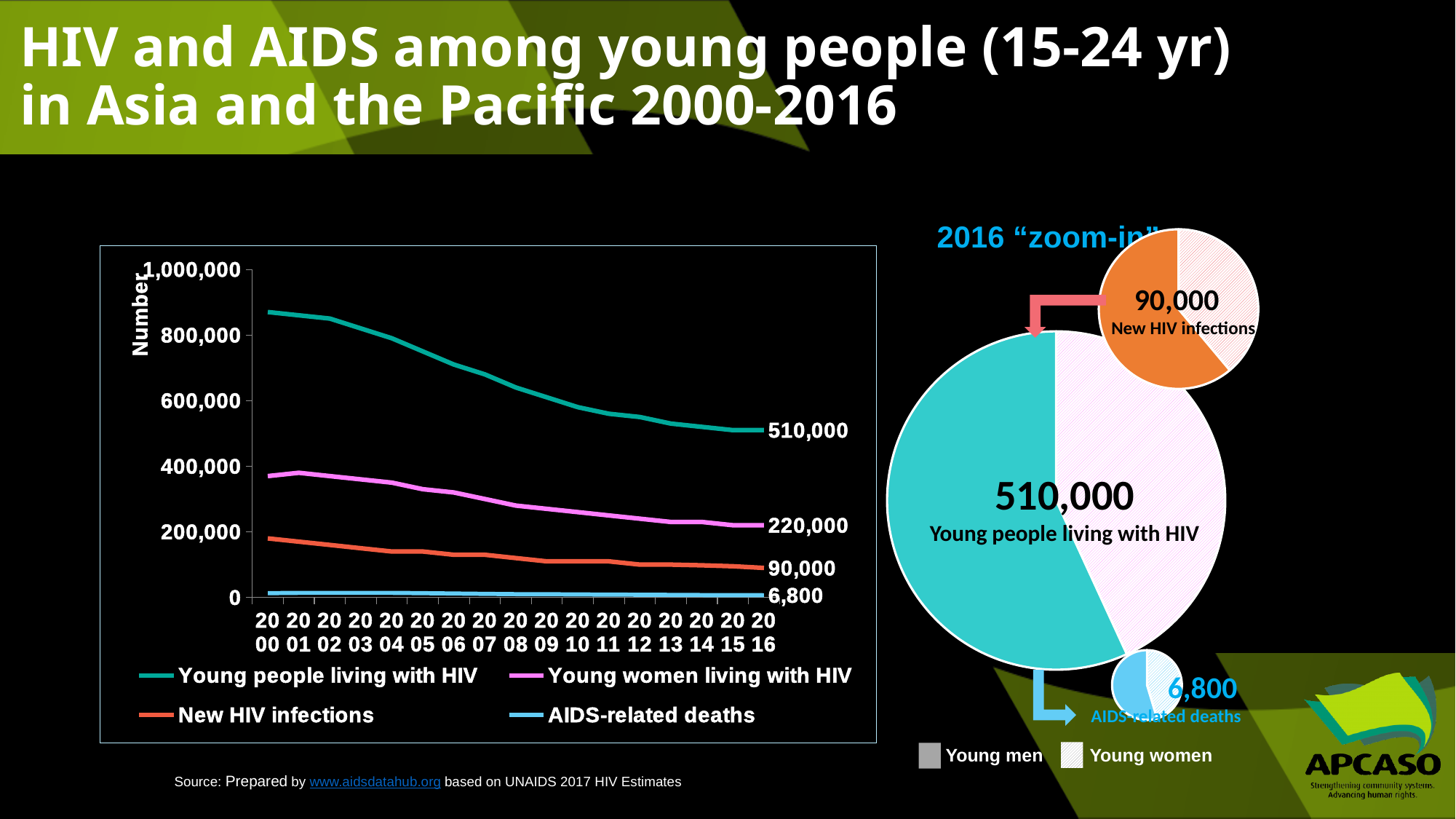
In the line chart, what is the value for New HIV infections in 2016? 90,000 What kind of chart is the chart on the left of the slide? line chart In the line chart, is the value for New HIV infections in 2000 greater or less than 200,000? less In the line chart, how many years are shown on the x axis? 17 In the line chart, what is the difference between Young people living with HIV and Young women living with HIV in 2016? 290,000 In the line chart, what is the value for AIDS-related deaths in 2016? 6,800 In the 2016 "zoom-in" pie charts on the right, which two groups does the legend list? Young men and Young women In the line chart, what is the value for Young people living with HIV in 2016? 510,000 In the line chart, what is the value for Young women living with HIV in 2016? 220,000 In the line chart, how many series does the legend list? 4 In the line chart, does the Young people living with HIV series rise or fall from 2000 to 2016? fall In the line chart, is the value for Young people living with HIV in 2000 greater or less than 800,000? greater